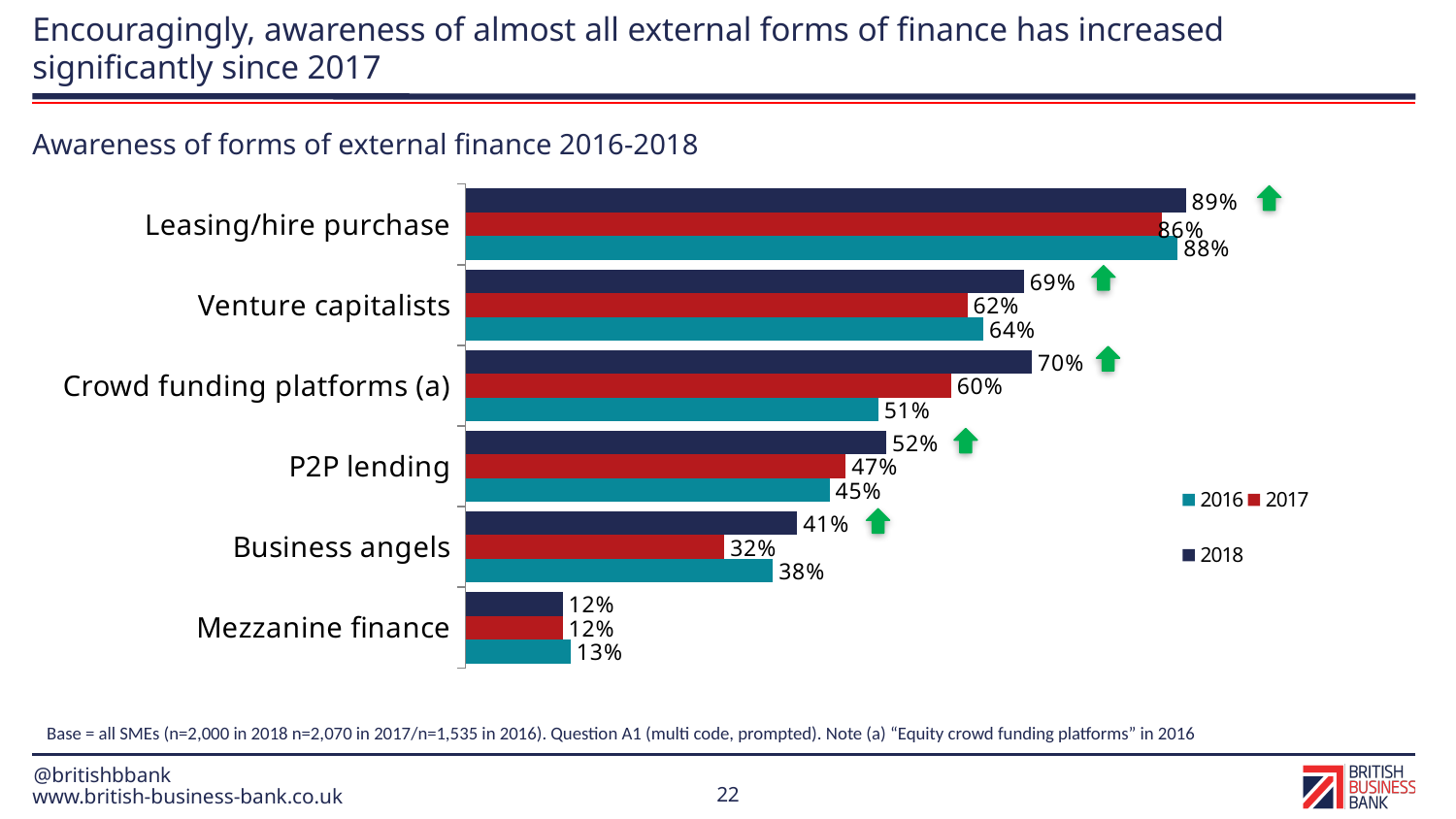
What kind of chart is shown on the slide? Bar chart What is the 2018 awareness value for Venture capitalists? 69% Which form of finance has the highest 2018 awareness? Leasing/hire purchase What is the 2016 awareness value for Crowd funding platforms (a)? 51% How many series does the legend list? 3 How many forms of external finance are shown in the chart? 6 What is the difference between the 2018 and 2017 awareness values for Business angels? 9% Which form of finance has the lowest 2017 awareness? Mezzanine finance What is the difference between the 2018 and 2016 awareness values for Crowd funding platforms (a)? 19% Which is larger: the 2018 awareness for Venture capitalists or the 2018 awareness for Crowd funding platforms (a)? Crowd funding platforms (a) What is the title of the chart? Awareness of forms of external finance 2016-2018 What is the 2017 awareness value for Business angels? 32%